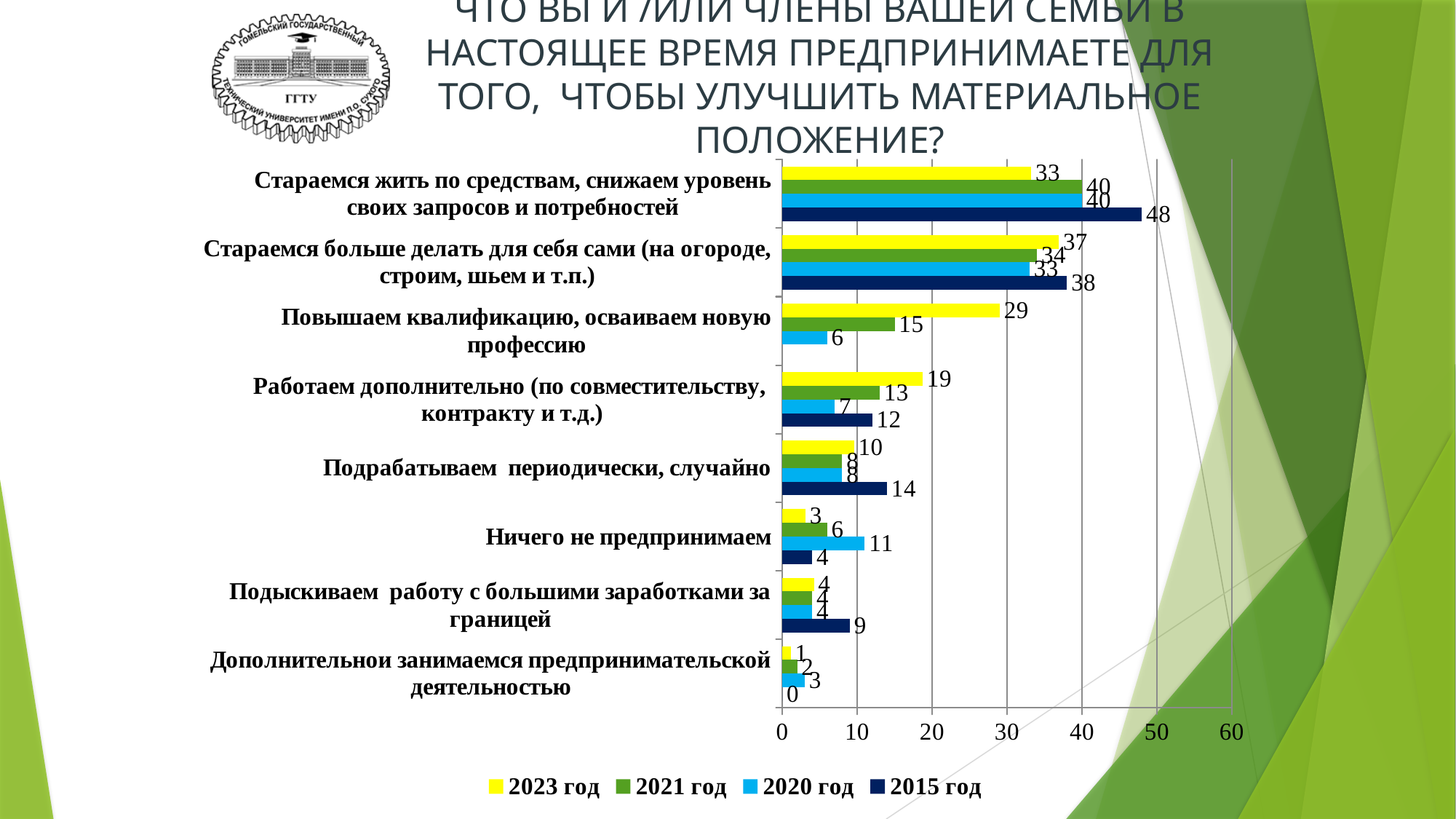
How many categories are shown on the chart? 8 Which colour represents 2020 год in the legend? Light blue Which category has the highest value for 2023 год? Стараемся больше делать для себя сами (на огороде, строим, шьем и т.п.) Which category has the lowest value for 2021 год? Дополнительно занимаемся предпринимательской деятельностью For "Работаем дополнительно (по совместительству, контракту и т.д.)", which is larger: the 2023 год value or the 2015 год value? 2023 год What is the value for 2015 год for "Стараемся жить по средствам, снижаем уровень своих запросов и потребностей"? 48 Is the 2015 год value for "Стараемся больше делать для себя сами (на огороде, строим, шьем и т.п.)" greater or less than 30? greater What kind of chart is shown on the slide? Bar chart How many series does the legend list? 4 What is the difference between the 2015 год and 2023 год values for "Стараемся жить по средствам, снижаем уровень своих запросов и потребностей"? 15 What is the value for 2023 год for "Повышаем квалификацию, осваиваем новую профессию"? 29 What is the value for 2020 год for "Ничего не предпринимаем"? 11